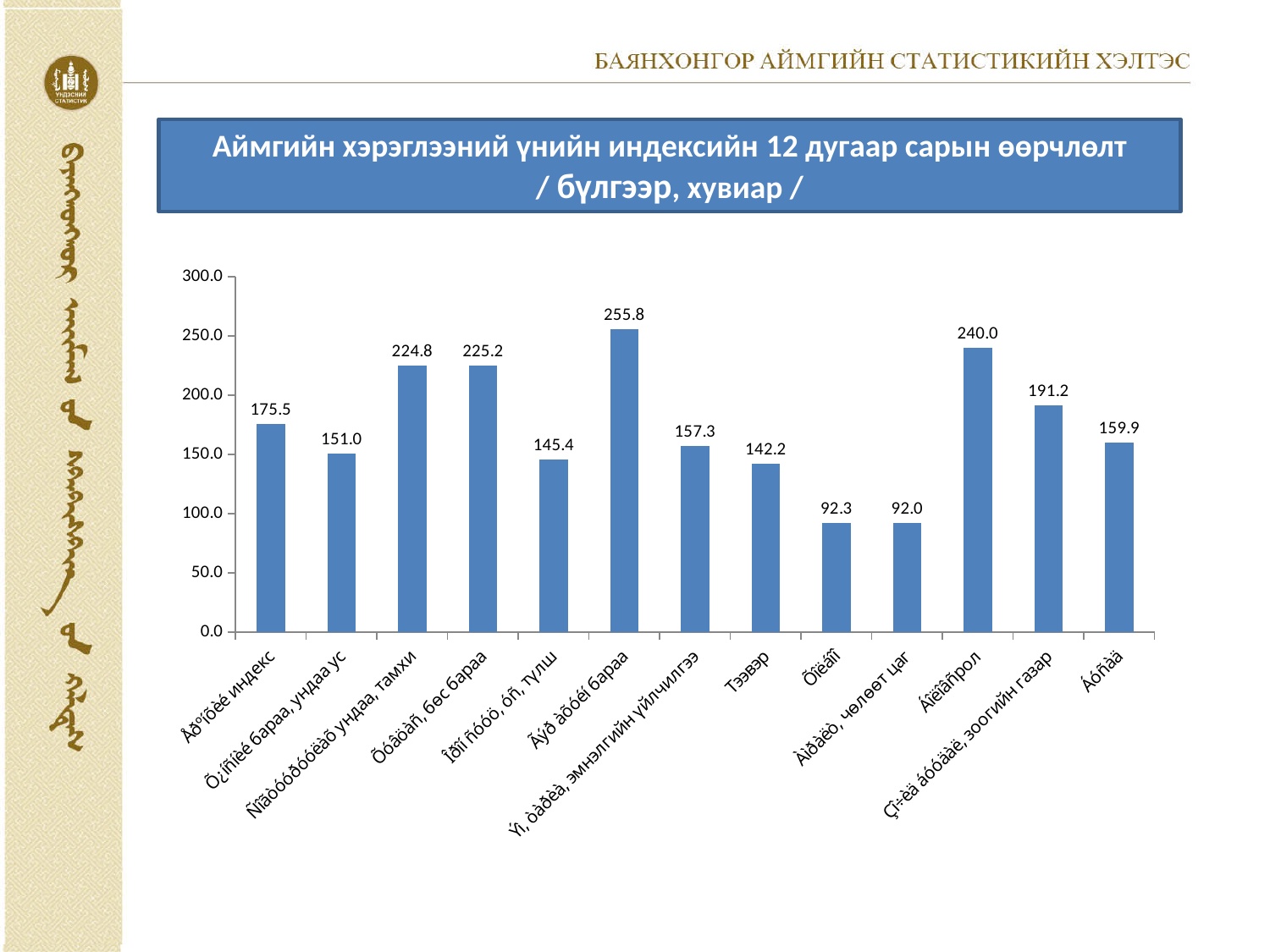
What is the value of the leftmost bar in the chart? 175.5 What is the difference between the highest bar (255.8) and the value for Тээвэр (142.2)? 113.6 What is the value of the rightmost bar in the chart? 159.9 Is the value for Тээвэр greater or less than 150? less What is the value for the category whose label ends in 'тамхи'? 224.8 What is the value for Тээвэр? 142.2 Which is larger: the value for Тээвэр or the value for the category whose label ends in 'чөлөөт цаг'? Тээвэр What is the difference between the fourth bar (225.2) and the third bar (224.8)? 0.4 What kind of chart is shown on the slide? bar chart What is the highest value shown in the chart? 255.8 What is the title of the chart on the slide? Аймгийн хэрэглээний үнийн индексийн 12 дугаар сарын өөрчлөлт / бүлгээр, хувиар / How many bars are plotted in the chart? 13